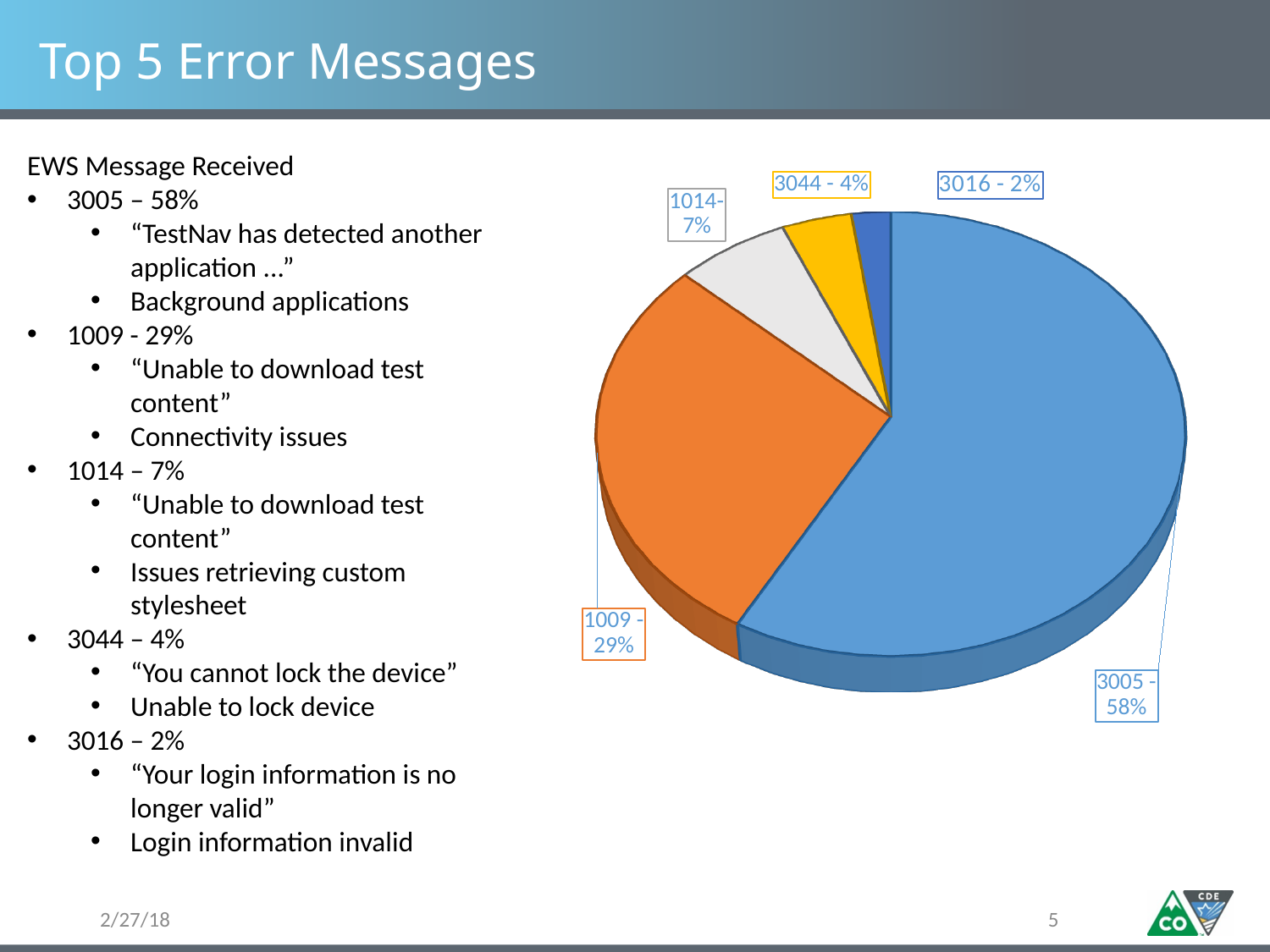
What percentage of the pie does error message 3044 account for? 4% What colour is the slice for error message 3044? Yellow What kind of chart is shown on the slide? Pie chart How many slices does the pie chart have? 5 What percentage of the pie does error message 1009 account for? 29% What percentage of the pie does error message 3016 account for? 2% Which error message has the smallest slice of the pie? 3016 Which has a larger share of the pie, error 1014 or error 3044? 1014 What percentage of the pie does error message 3005 account for? 58% What is the difference in percentage points between error 3005 and error 1009? 29 Which error message has the largest slice of the pie? 3005 What percentage of the pie does error message 1014 account for? 7%